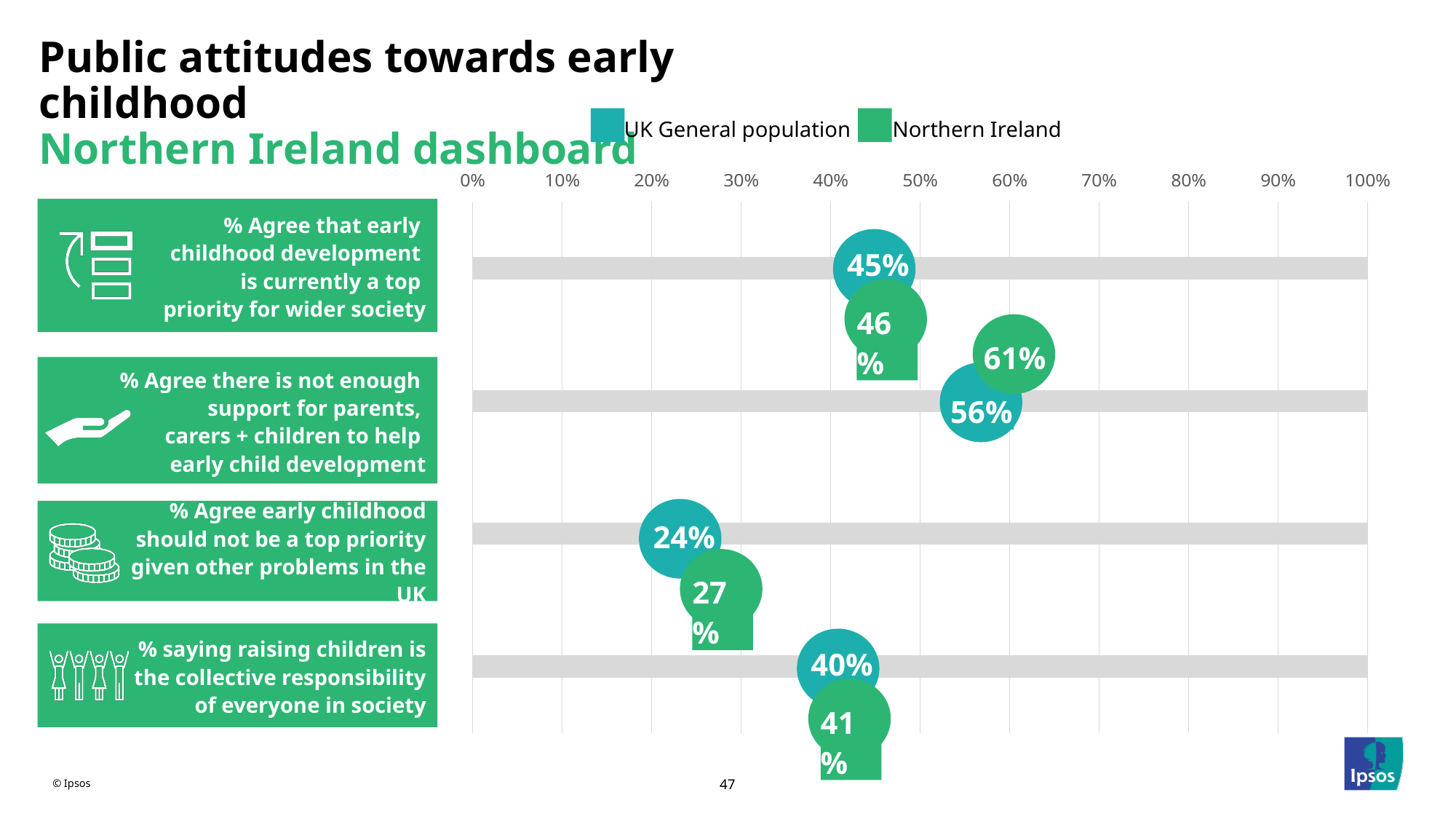
On '% Agree early childhood should not be a top priority given other problems in the UK', which is larger: the UK General population value or the Northern Ireland value? Northern Ireland What is the highest value shown on the horizontal axis? 100% Which statement has the highest Northern Ireland value? % Agree there is not enough support for parents, carers + children to help early child development What is the value for UK General population on '% Agree that early childhood development is currently a top priority for wider society'? 45% Which statement has the lowest UK General population value? % Agree early childhood should not be a top priority given other problems in the UK What is the value for Northern Ireland on '% saying raising children is the collective responsibility of everyone in society'? 41% What is the difference between the Northern Ireland and UK General population values on '% Agree there is not enough support for parents, carers + children to help early child development'? 5 percentage points What is the value for Northern Ireland on '% Agree there is not enough support for parents, carers + children to help early child development'? 61% What is the value for UK General population on '% Agree early childhood should not be a top priority given other problems in the UK'? 24% What are the two series named in the legend? UK General population and Northern Ireland How many series does the legend list? 2 How many statements are plotted on the chart? 4